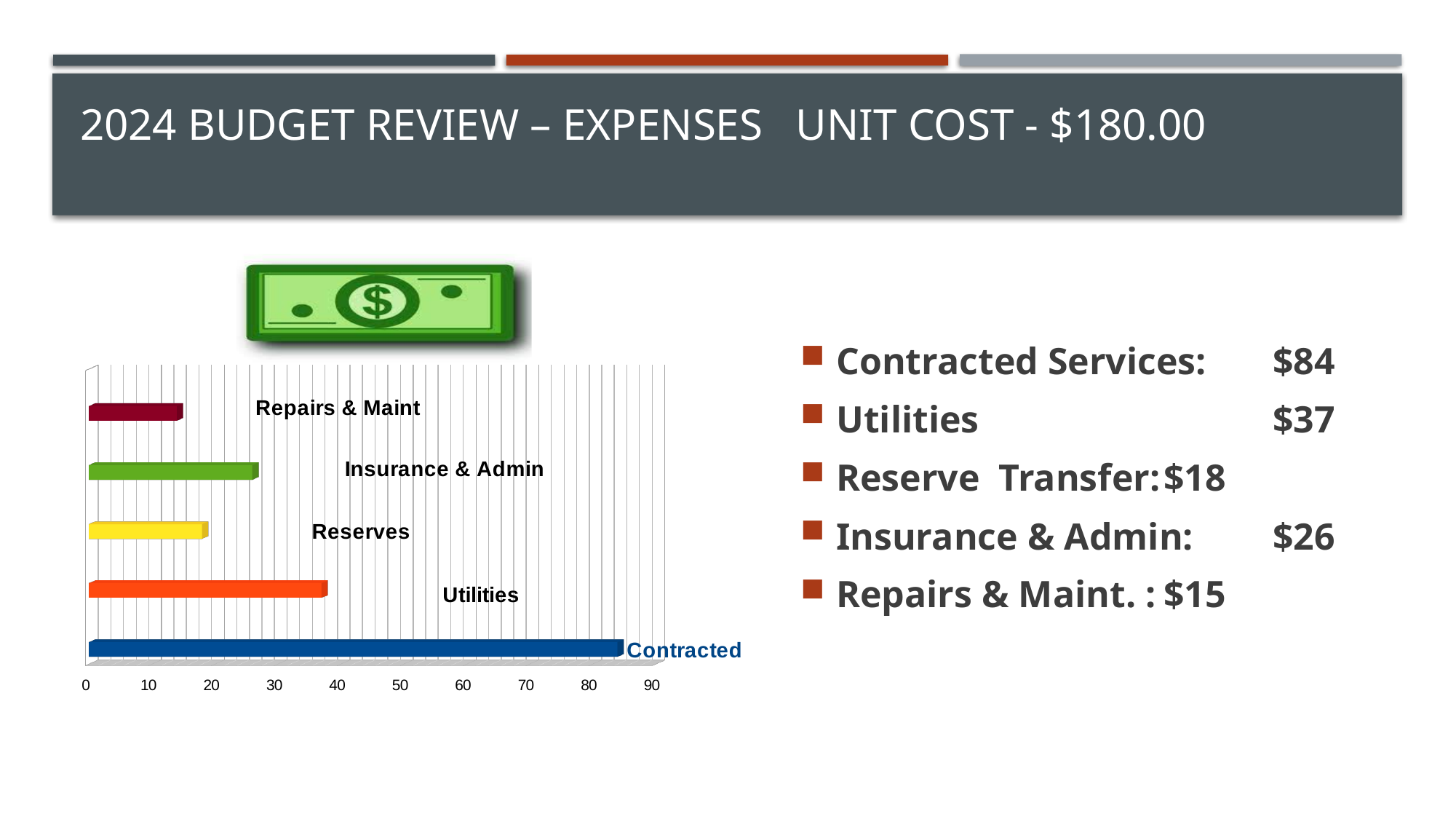
Is the value for Insurance & Admin greater or less than 20? greater Is the value for Repairs & Maint greater or less than 20? less Which category has the longest bar in the chart? Contracted What colour is the Contracted bar in the chart? blue What kind of chart is shown on the slide? bar chart Is the value for Contracted greater or less than 80? greater Which bar is longer, Utilities or Insurance & Admin? Utilities What is the highest tick value shown on the horizontal axis of the chart? 90 How many categories are plotted in the bar chart? 5 Which bar is longer, Contracted or Utilities? Contracted